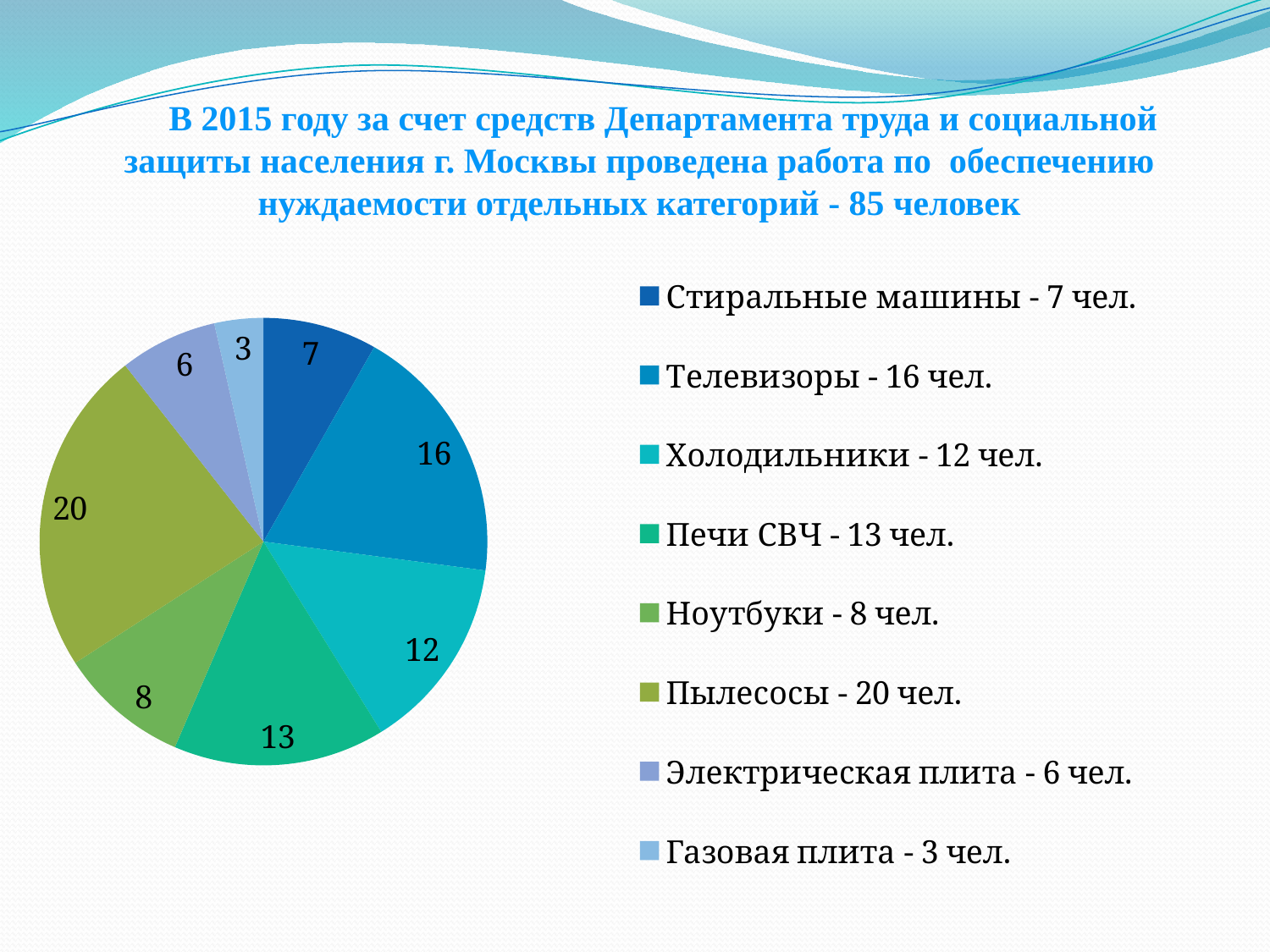
What is the value for Холодильники? 12 Which is larger, the value for Печи СВЧ or the value for Ноутбуки? Печи СВЧ What is the difference between the values for Телевизоры and Холодильники? 4 What is the value for Пылесосы? 20 What kind of chart is shown on the slide? pie chart How many entries does the legend list? 8 What is the total of all slices in the pie chart? 85 Which category has the largest slice? Пылесосы Which category has the smallest slice? Газовая плита What is the value for Газовая плита? 3 What is the difference between the values for Пылесосы and Газовая плита? 17 How many slices does the pie chart have? 8